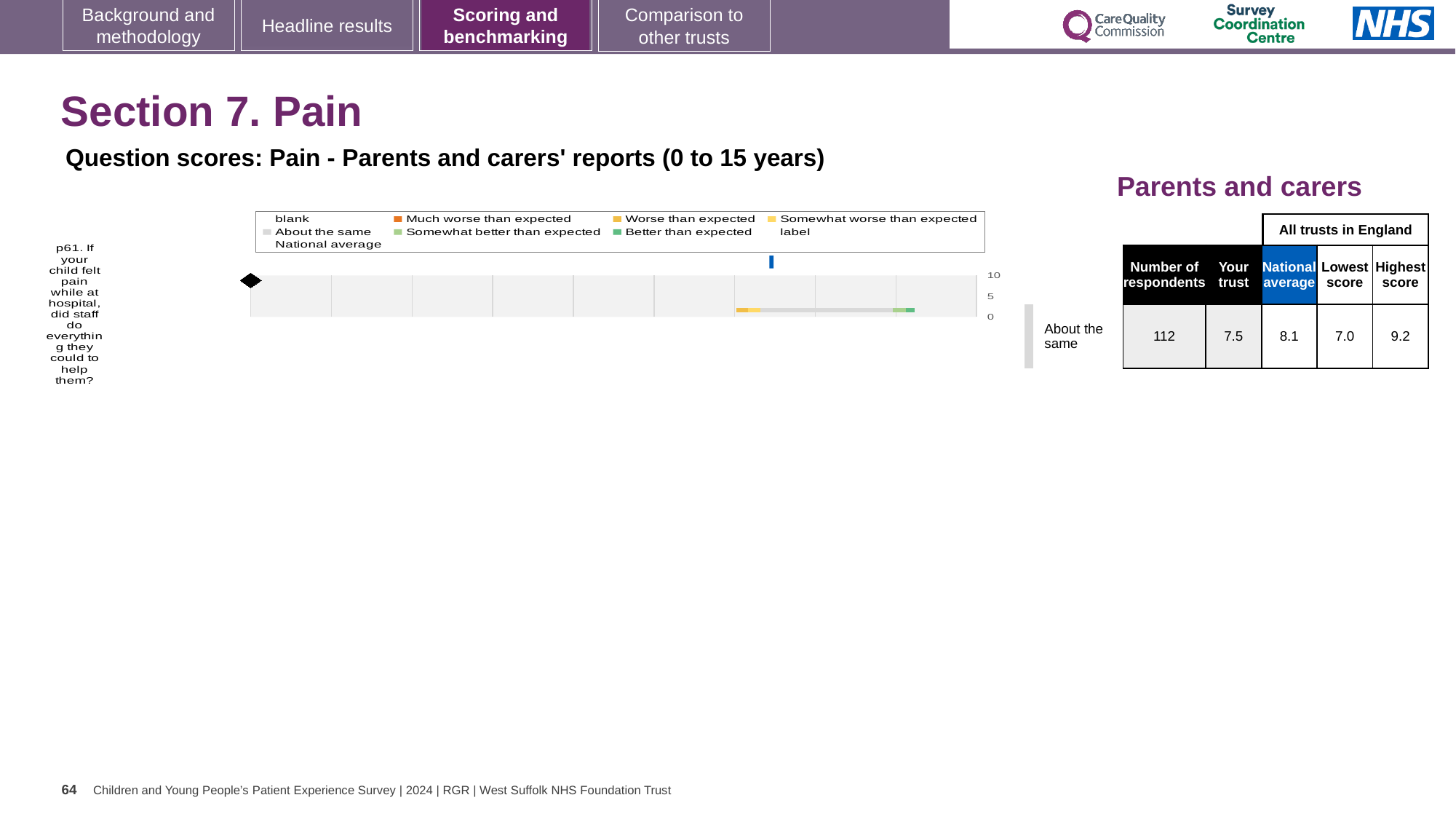
By how much does the national average exceed the 'Your trust' score for question p61? 0.6 Which survey question is plotted in the chart? p61. If your child felt pain while at hospital, did staff do everything they could to help them? What is the lowest score among all trusts in England for question p61? 7.0 What is the difference between the highest and lowest scores for question p61? 2.2 What kind of chart is shown on the slide? bar chart What is the highest score among all trusts in England for question p61? 9.2 What is the national average score for question p61 in the table beside the chart? 8.1 What benchmark category is the trust's result for question p61 placed in? About the same How many respondents answered question p61? 112 What is the 'Your trust' score for question p61 in the table beside the chart? 7.5 How many survey questions are plotted in the chart? 1 Which is larger for question p61: the 'Your trust' score or the national average? National average